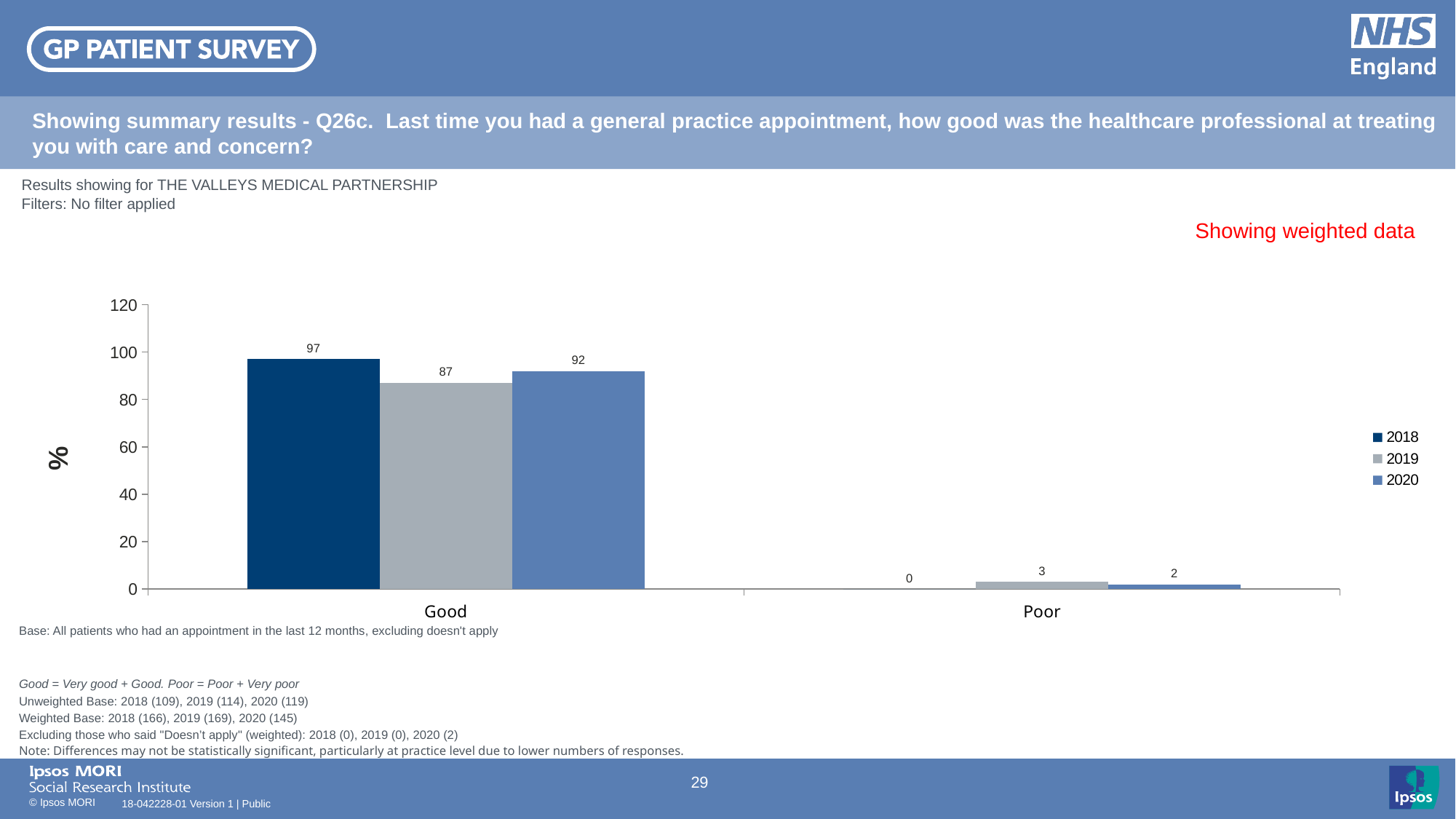
How many series does the legend list? 3 What is the value for 2018 in the Poor category? 0 Which year has the highest value in the Good category? 2018 Which year has the lowest value in the Good category? 2019 How many categories are shown on the x axis? 2 What is the value for 2019 in the Good category? 87 Which is larger in the Poor category, the 2019 value or the 2020 value? 2019 Is the value for 2019 in the Good category greater or less than 80? greater What kind of chart is shown on the slide? bar chart What is the value for 2018 in the Good category? 97 What is the difference between the 2018 and 2020 values in the Good category? 5 What is the value for 2020 in the Poor category? 2